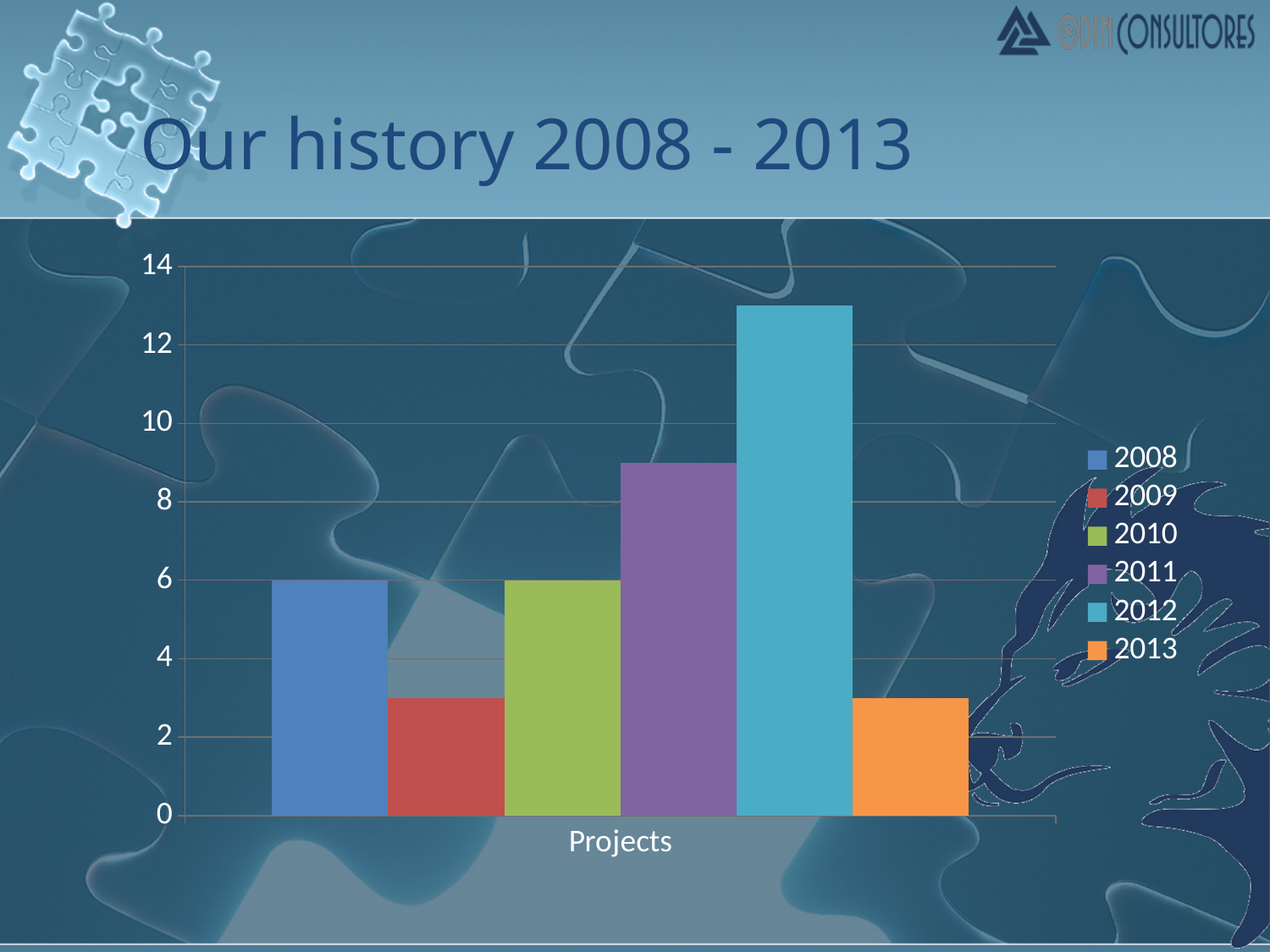
Is the value for 2012 greater or less than 12? greater What is the category label shown on the x axis? Projects Is the value for 2013 greater or less than 4? less Which year has the highest value for Projects? 2012 What is the value for 2008 in the Projects category? 6 What is the value for 2010 in the Projects category? 6 Which is larger, the value for 2011 or the value for 2010? 2011 What is the title of the slide containing the chart? Our history 2008 - 2013 What kind of chart is shown on the slide? bar chart Is the value for 2009 greater or less than 4? less How many series does the legend list? 6